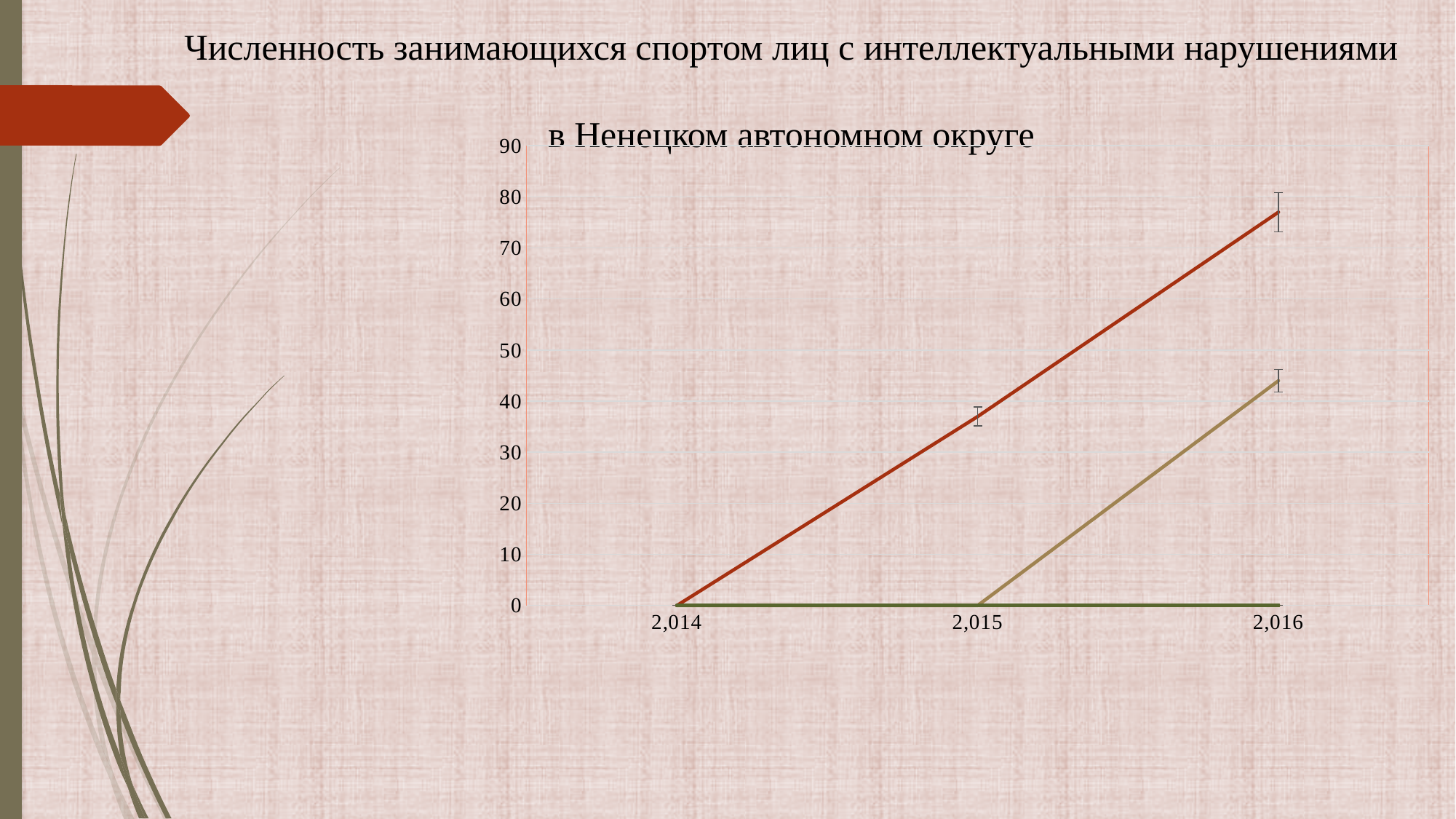
What kind of chart is shown on the slide? line chart In which year does the red line reach its highest value? 2,016 What is the title of the chart on the slide? Численность занимающихся спортом лиц с интеллектуальными нарушениями в Ненецком автономном округе Is the value of the red line at 2,015 greater or less than 30? greater What is the value of the red line at 2,014? 0 What is the value of the tan (gold) line at 2,015? 0 Is the value of the tan (gold) line at 2,016 greater or less than 50? less How many years are marked on the x axis of the chart? 3 At 2,016, which line is higher, the red line or the tan (gold) line? the red line Is the value of the red line at 2,016 greater or less than 70? greater Does the red line rise or fall from 2,014 to 2,016? rises What is the highest value shown on the y axis of the chart? 90